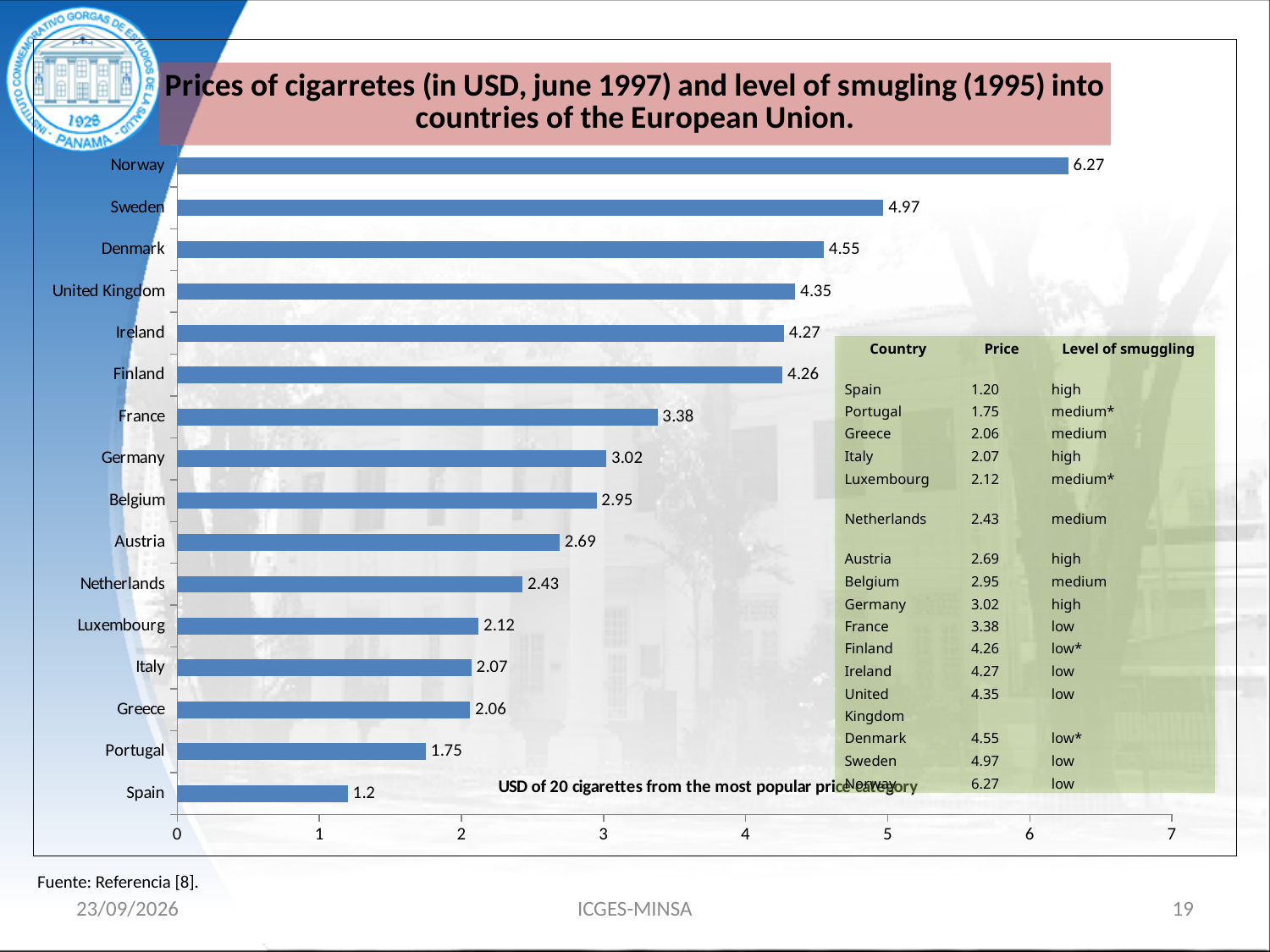
What is the difference between the cigarette prices of Denmark and the United Kingdom? 0.20 How many countries are shown in the bar chart? 16 Which has a higher cigarette price, Austria or Netherlands? Austria Which country has the lowest cigarette price in the chart? Spain Which has a higher cigarette price, France or Belgium? France What is the cigarette price shown for Norway? 6.27 What is the cigarette price shown for Germany? 3.02 What is the label shown along the x axis of the chart? USD of 20 cigarettes from the most popular price category What type of chart is shown on the slide? Bar chart What is the difference between the cigarette prices of Norway and Sweden? 1.30 Which country has the highest cigarette price in the chart? Norway What is the cigarette price shown for Spain? 1.2